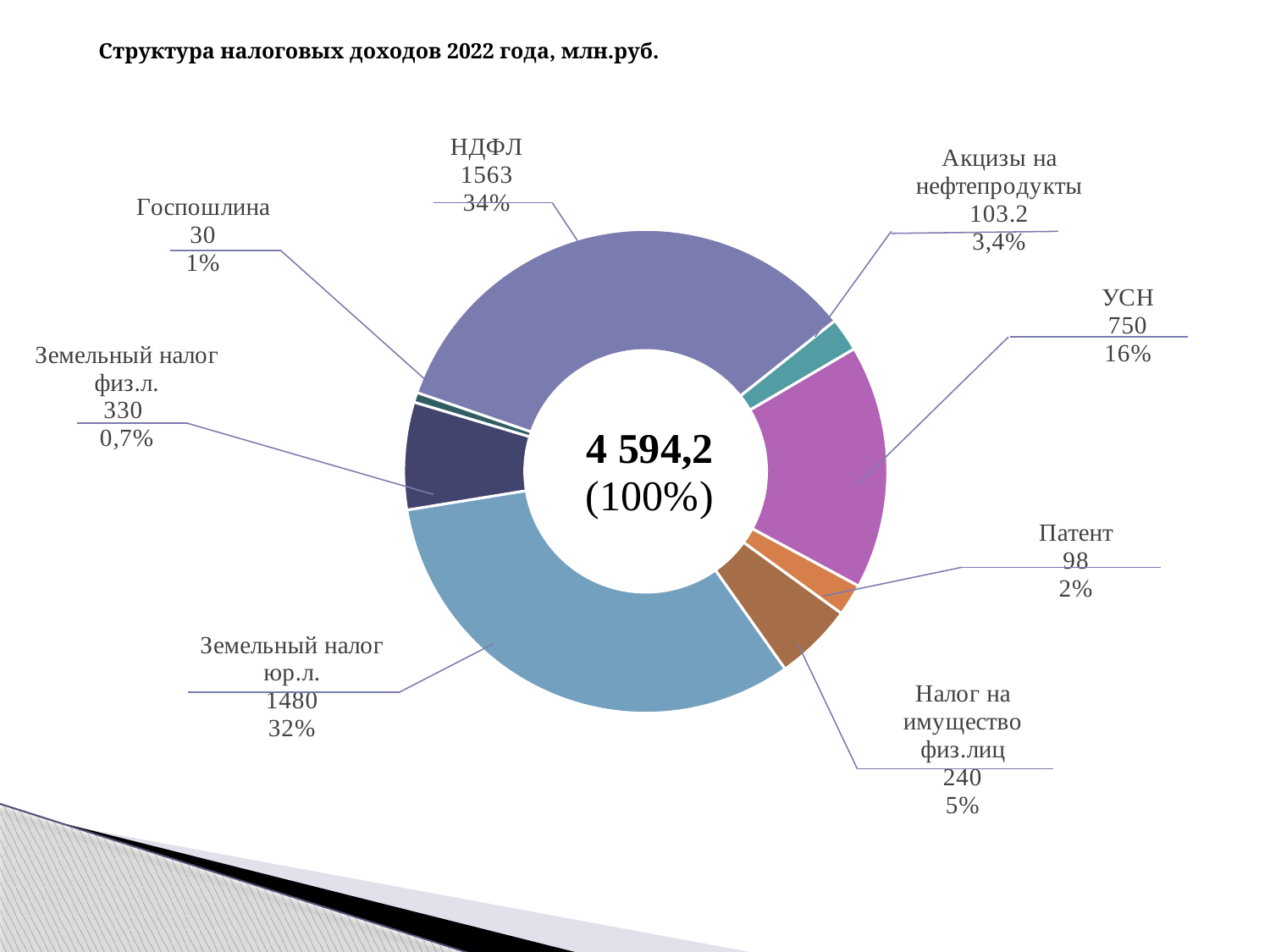
What is the value for НДФЛ? 1563 How many categories does the chart show? 8 What is the title of the chart? Структура налоговых доходов 2022 года, млн.руб. What share of the total does УСН represent? 16% What kind of chart is shown on the slide? Pie (donut) chart What is the value for Акцизы на нефтепродукты? 103.2 Which category has the highest value? НДФЛ What is the value for Налог на имущество физ.лиц? 240 Which category has the lowest value? Госпошлина What total value is shown in the centre of the chart? 4 594,2 What is the difference between the values for НДФЛ and Земельный налог юр.л.? 83 Which is larger, УСН or Налог на имущество физ.лиц? УСН